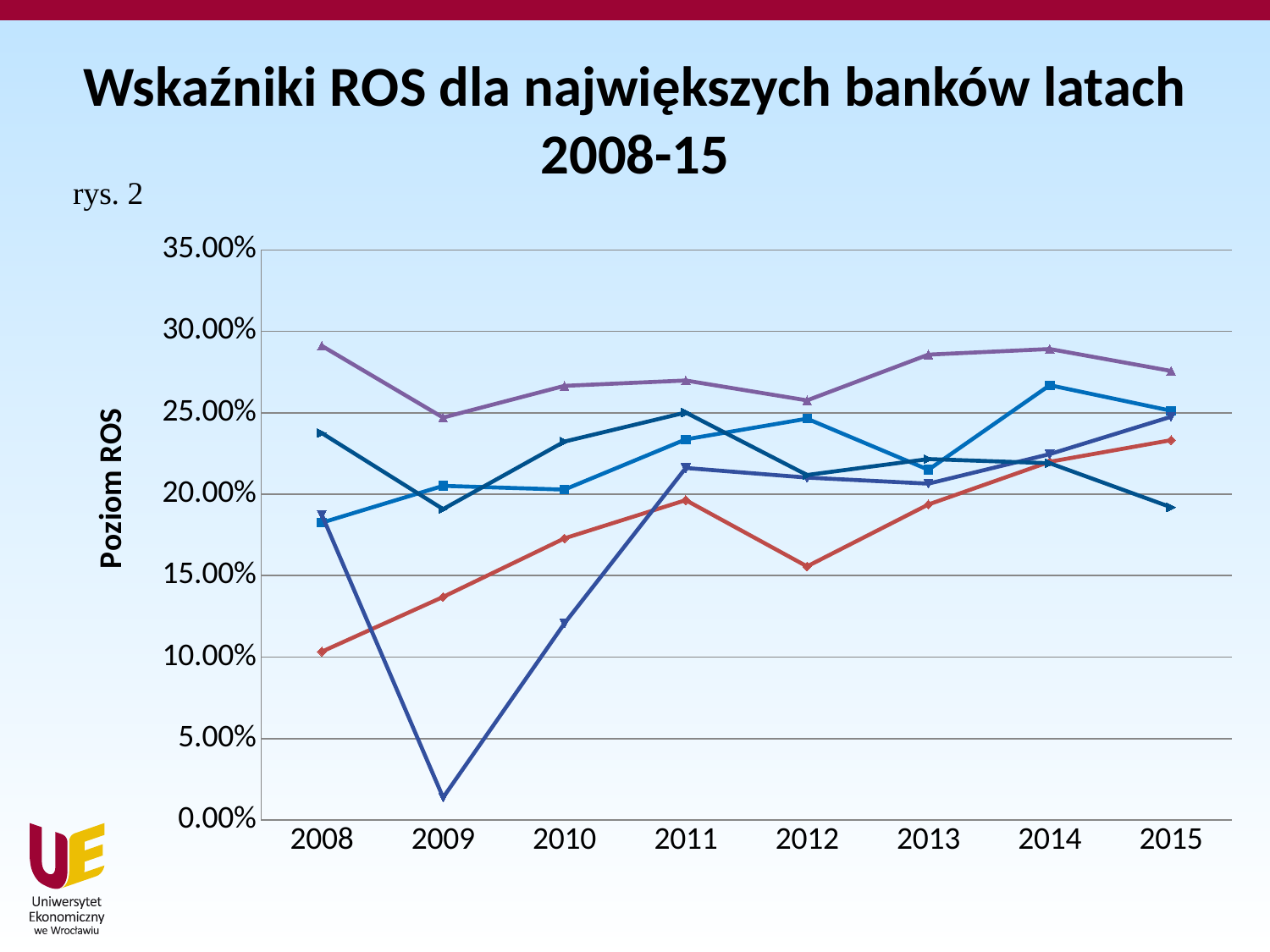
Is the value of the purple line in 2013 greater or less than 25.00%? greater How many lines are plotted on the chart? 5 How many years are shown along the x axis of the chart? 8 Is the value of the red line in 2008 greater or less than 15.00%? less What is the highest value shown on the vertical axis? 35.00% Is the value of the medium blue line with star markers in 2009 greater or less than 5.00%? less What is the label of the vertical axis? Poziom ROS What kind of chart is shown on the slide? line chart Which is larger in 2015: the value of the purple line or the value of the red line? the purple line Does the red line rise or fall from 2012 to 2015? rises In which year does the medium blue line with star markers reach its lowest point? 2009 Which line has the highest value in 2008? the purple line